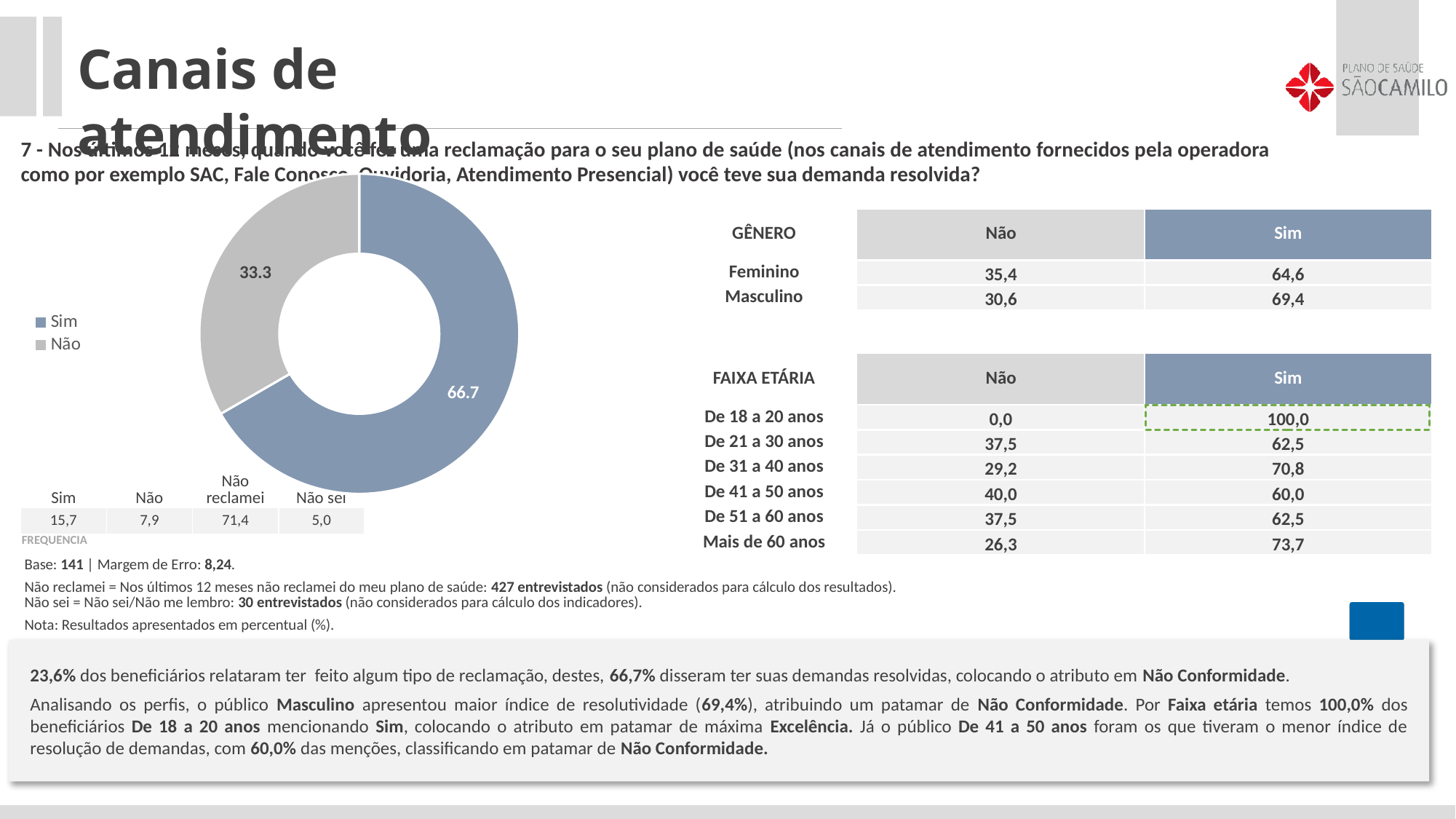
What value does the donut chart show for Sim? 66.7 What share of the donut chart does the Sim slice represent? 66.7 How many slices does the donut chart have? 2 Which slice of the donut chart is the largest? Sim Is the value for Sim in the donut chart greater or less than 50? greater What value does the donut chart show for Não? 33.3 What kind of chart is shown on the left of the slide? Pie (donut) chart How many entries does the legend of the donut chart list? 2 Which slice of the donut chart is the smallest? Não What colour is the Sim slice in the donut chart? Blue In the donut chart, which is larger: Sim or Não? Sim What is the difference between the Sim and Não values in the donut chart? 33.4